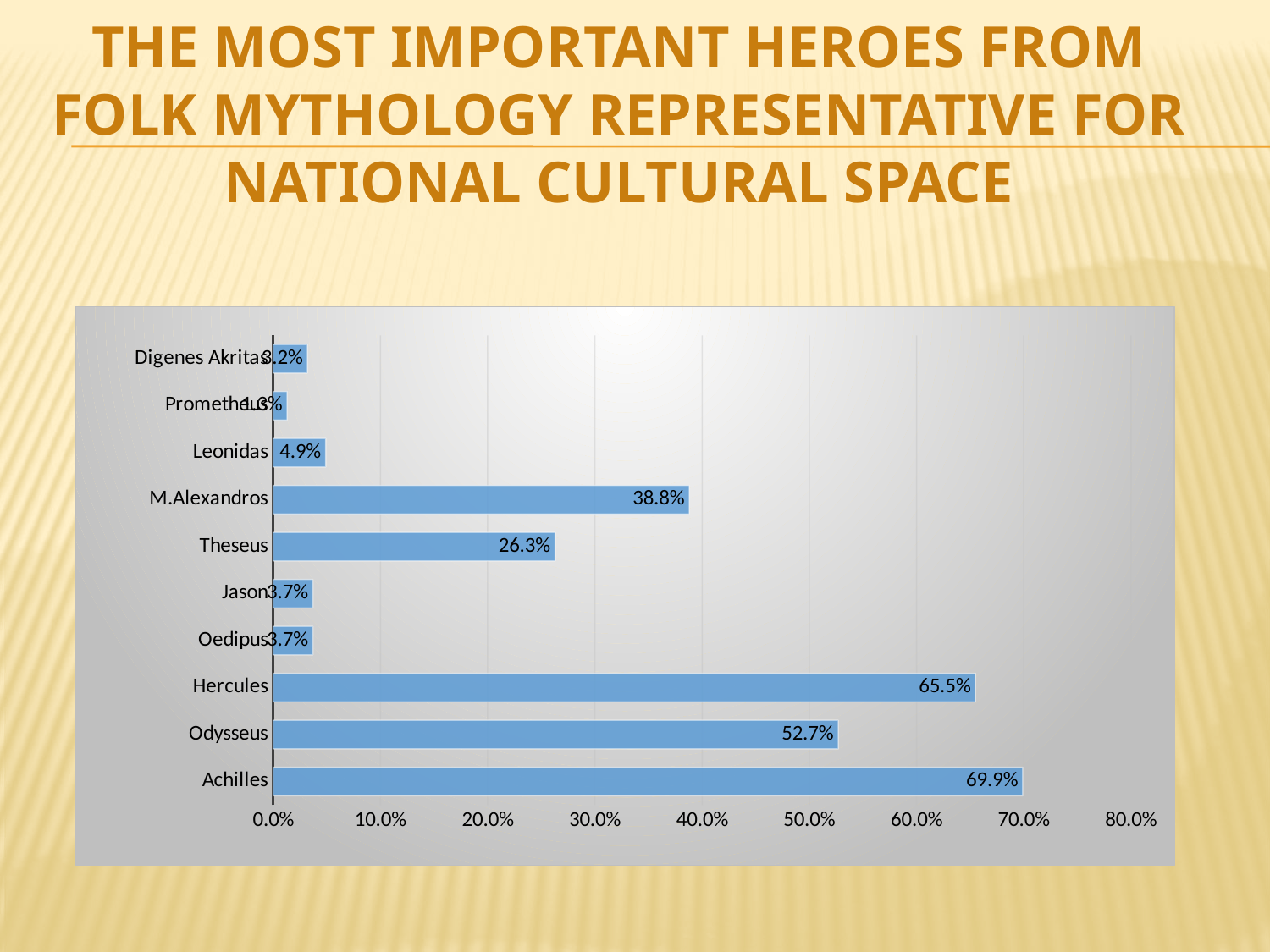
Which has a larger value, Odysseus or M.Alexandros? Odysseus What is the difference between the values for Hercules and Odysseus? 12.8% How many heroes are listed as categories in the chart? 10 What kind of chart is shown on the slide? bar chart What is the difference between the values for M.Alexandros and Theseus? 12.5% What is the value for Hercules? 65.5% Is the value for Theseus greater or less than 20.0%? greater What is the value for M.Alexandros? 38.8% Which hero has the highest value in the chart? Achilles What is the value for Achilles? 69.9% What is the value for Leonidas? 4.9% Which hero has the lowest value in the chart? Prometheus